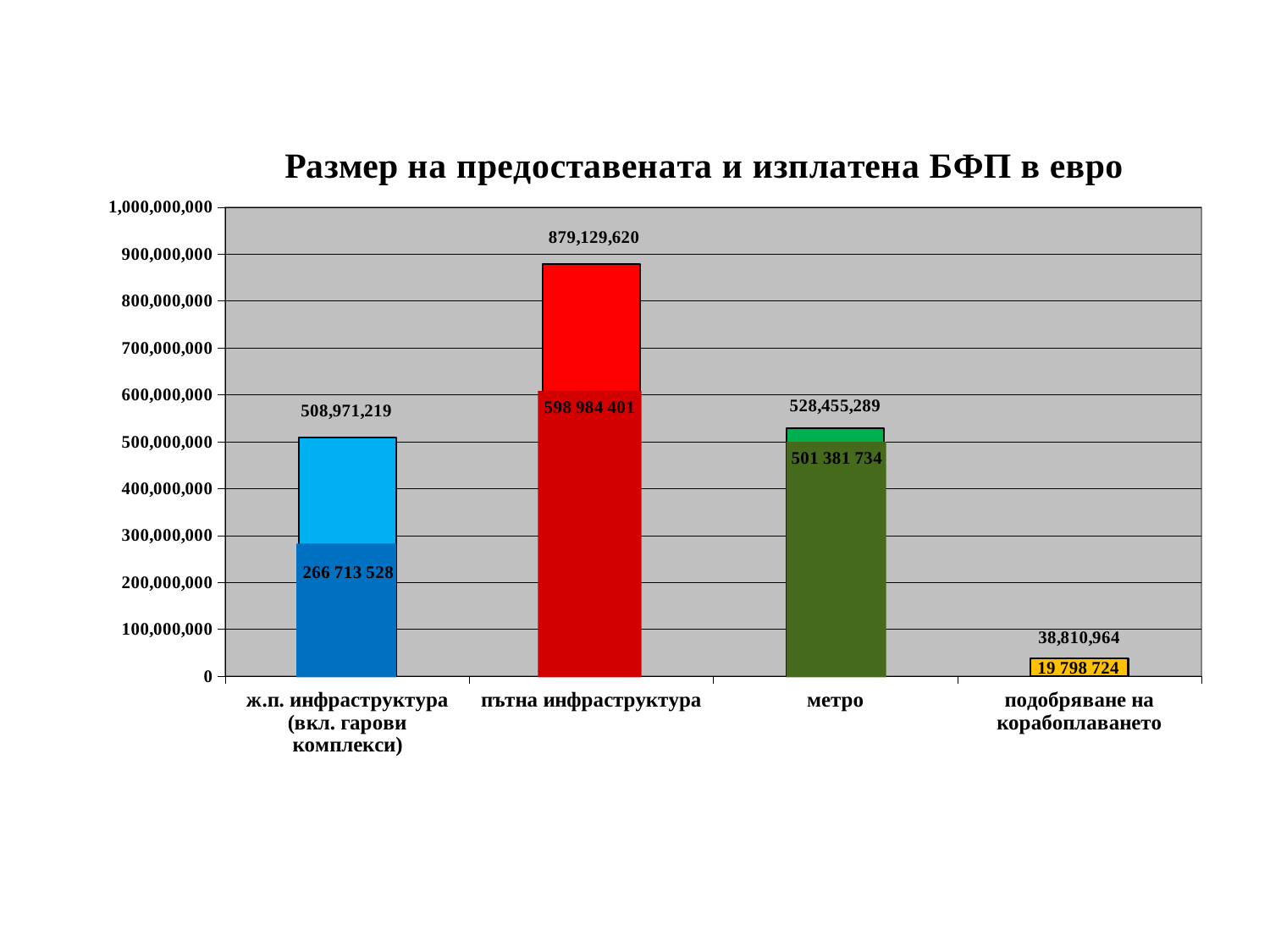
Which category has the lowest granted value? подобряване на корабоплаването How many categories are shown on the x axis? 4 What is the difference between the granted values for пътна инфраструктура and метро? 350,674,331 What is the inner (paid) value shown for ж.п. инфраструктура (вкл. гарови комплекси)? 266 713 528 Which category has the highest granted value? пътна инфраструктура What is the title of the chart? Размер на предоставената и изплатена БФП в евро For ж.п. инфраструктура (вкл. гарови комплекси), what is the difference between the granted value (508,971,219) and the paid value (266 713 528)? 242,257,691 What is the inner (paid) value shown for метро? 501 381 734 Which is larger: the granted value for метро or the granted value for ж.п. инфраструктура (вкл. гарови комплекси)? метро Is the granted value for метро greater or less than 500,000,000? greater What is the top (granted) value shown for подобряване на корабоплаването? 38,810,964 What is the top (granted) value shown for пътна инфраструктура? 879,129,620